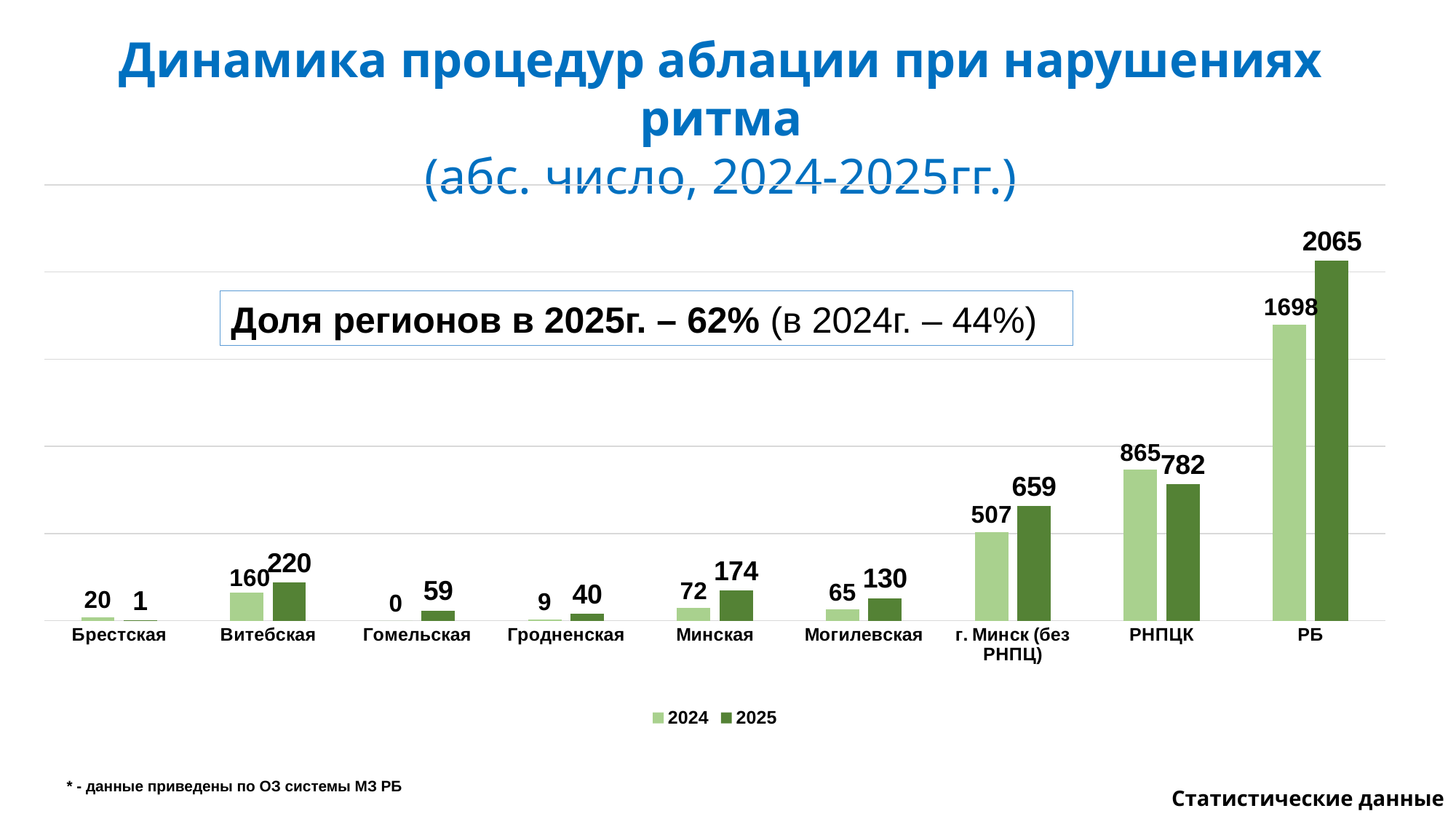
What is the difference between the 2024 and 2025 values for РНПЦК? 83 What is the 2024 value for Гомельская? 0 How many series does the legend list? 2 How many categories are shown on the x axis? 9 What is the difference between the 2025 and 2024 values for РБ? 367 What is the 2024 value for г. Минск (без РНПЦ)? 507 Which is larger for Минская: the 2024 value or the 2025 value? 2025 Which category has the lowest 2025 value? Брестская Which is larger for РНПЦК: the 2024 value or the 2025 value? 2024 What is the 2025 value for Витебская? 220 Which category has the highest 2025 value? РБ What kind of chart is shown on the slide? Bar chart